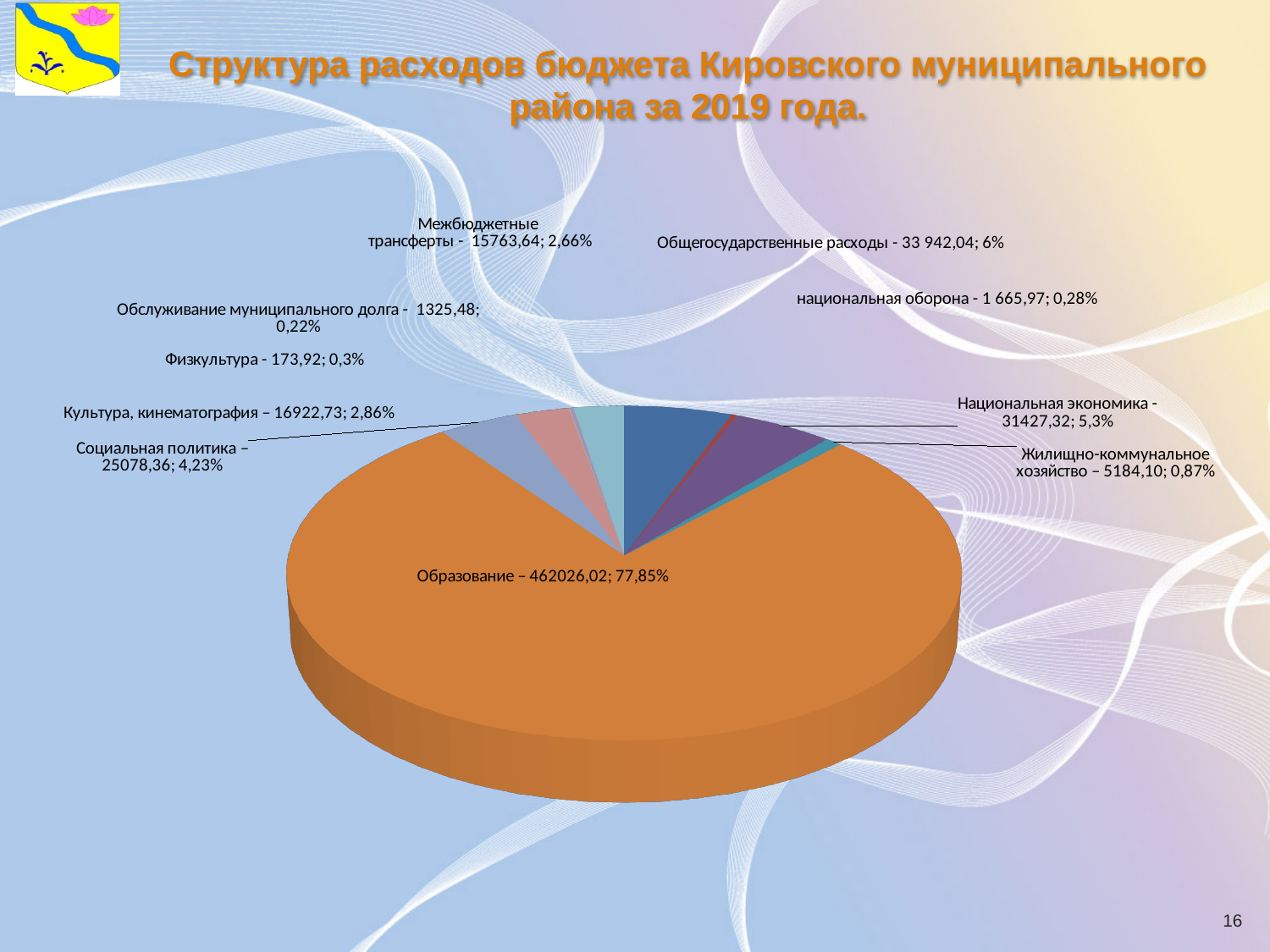
What share of the pie does Образование take? 77,85% What is the difference between the values for Общегосударственные расходы and Национальная экономика? 2514,72 Which category has the smallest value in the pie chart? Физкультура What is the value shown for Общегосударственные расходы? 33 942,04 Which category has the largest share of the pie? Образование What is the title of the slide's chart? Структура расходов бюджета Кировского муниципального района за 2019 года. How many categories does the pie chart show? 10 What percentage is shown for Национальная экономика? 5,3% What kind of chart is shown on the slide? pie chart What is the value shown for Социальная политика? 25078,36 Which is larger, Социальная политика or Культура, кинематография? Социальная политика What percentage is shown for Жилищно-коммунальное хозяйство? 0,87%